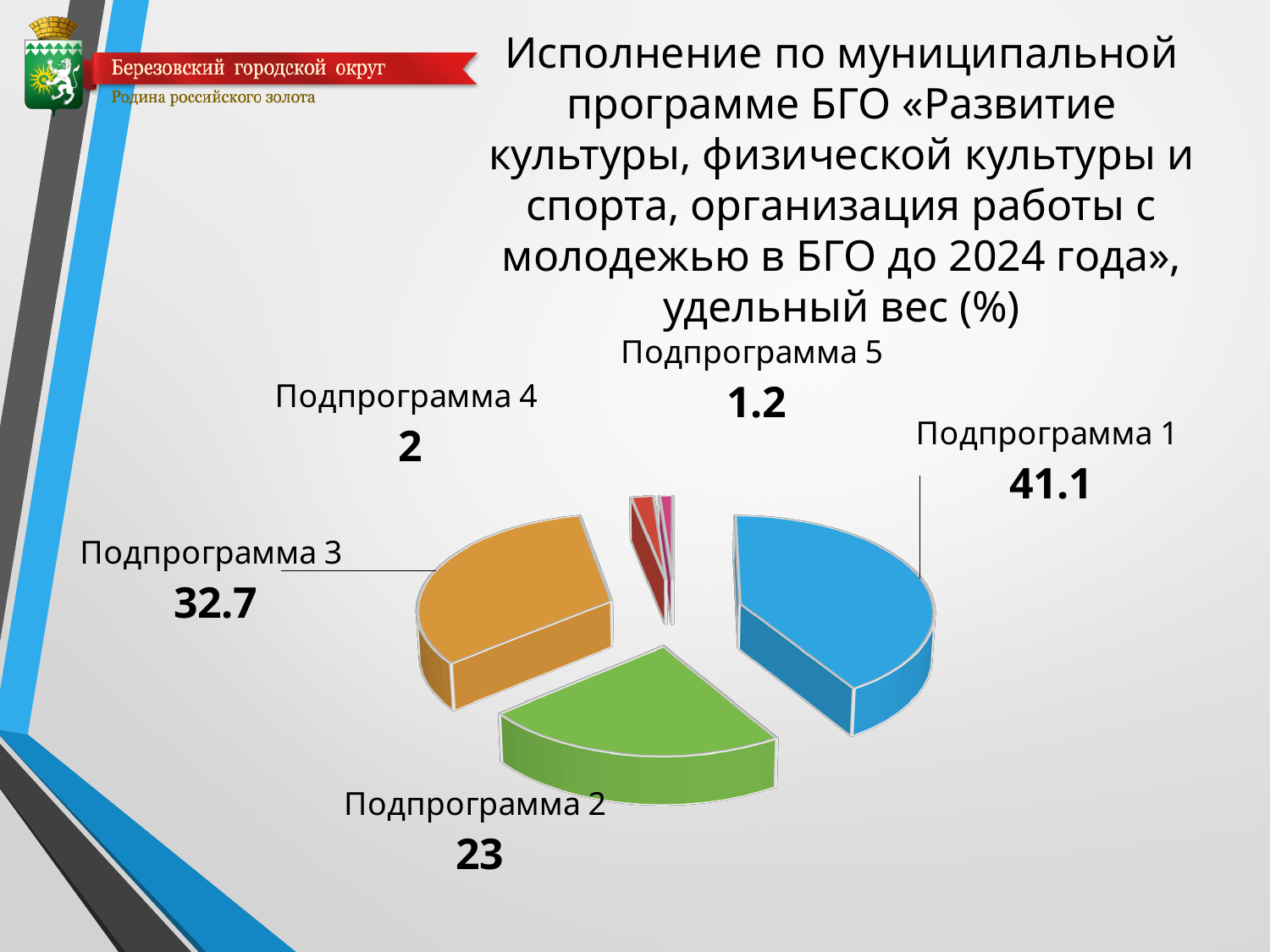
What is the value for Подпрограмма 2? 23 Which is larger, the value for Подпрограмма 2 or the value for Подпрограмма 3? Подпрограмма 3 Which subprogram has the smallest share of the pie? Подпрограмма 5 What type of chart is shown on the slide? Pie chart What colour is the slice for Подпрограмма 2? Green What is the value for Подпрограмма 3? 32.7 What is the value for Подпрограмма 1? 41.1 How many slices does the pie chart have? 5 Which subprogram has the largest share of the pie? Подпрограмма 1 What is the difference between the values for Подпрограмма 1 and Подпрограмма 3? 8.4 What is the difference between the values for Подпрограмма 4 and Подпрограмма 5? 0.8 What is the value for Подпрограмма 5? 1.2